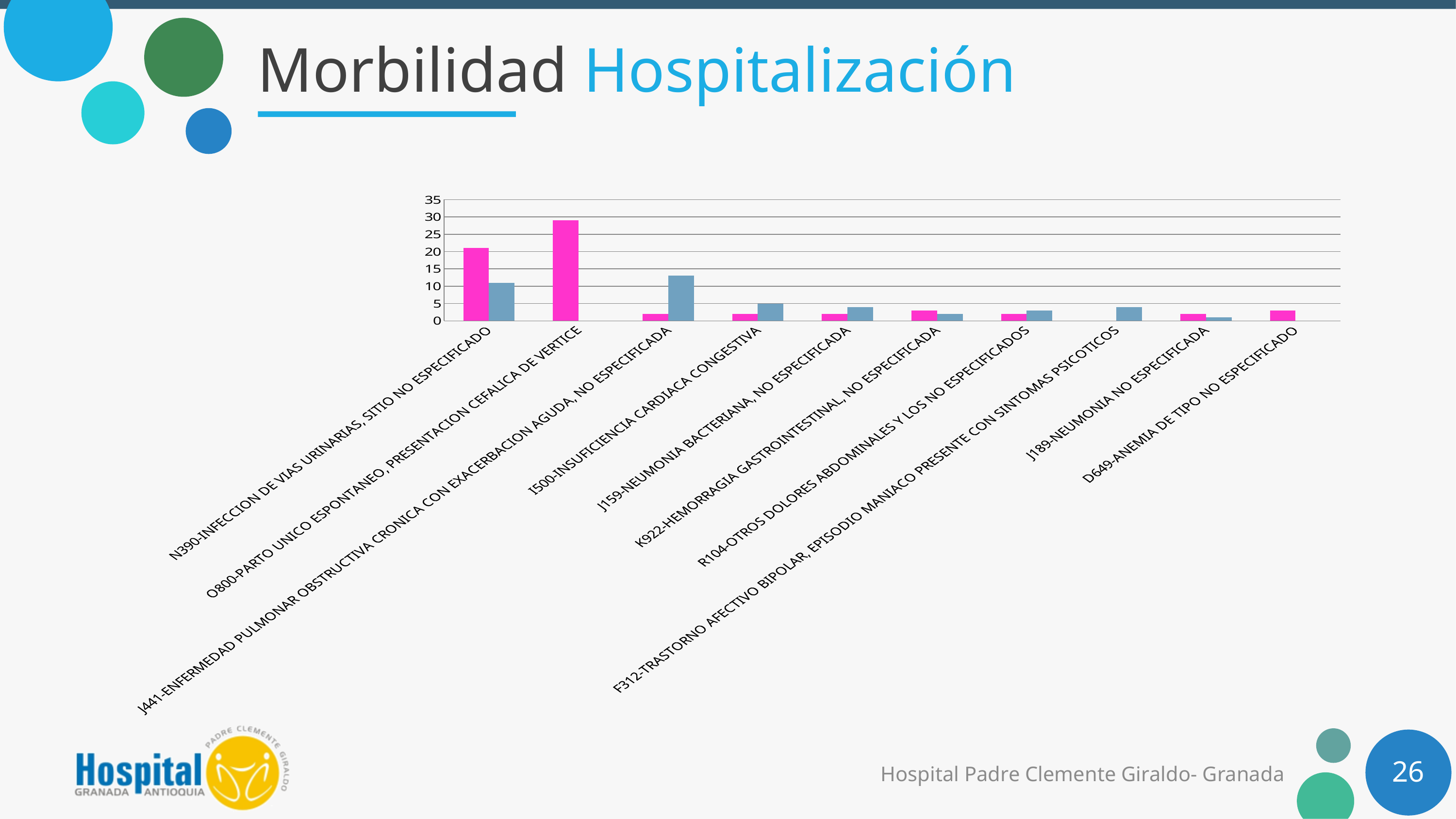
Which category has the tallest blue-gray bar in the chart? J441-ENFERMEDAD PULMONAR OBSTRUCTIVA CRONICA CON EXACERBACION AGUDA, NO ESPECIFICADA Is the blue-gray bar for I500-INSUFICIENCIA CARDIACA CONGESTIVA greater or less than 10? less What is the highest value shown on the chart's vertical axis? 35 Is the blue-gray bar for J441-ENFERMEDAD PULMONAR OBSTRUCTIVA CRONICA CON EXACERBACION AGUDA, NO ESPECIFICADA greater or less than 10? greater For N390-INFECCION DE VIAS URINARIAS, SITIO NO ESPECIFICADO, which bar is taller, the pink one or the blue-gray one? the pink one How many diagnosis categories are shown on the x axis of the chart? 10 For J441-ENFERMEDAD PULMONAR OBSTRUCTIVA CRONICA CON EXACERBACION AGUDA, NO ESPECIFICADA, which bar is taller, the pink one or the blue-gray one? the blue-gray one Is the pink bar for O800-PARTO UNICO ESPONTANEO, PRESENTACION CEFALICA DE VERTICE greater or less than 25? greater What kind of chart is shown on the slide? bar chart Which category has the tallest pink bar in the chart? O800-PARTO UNICO ESPONTANEO, PRESENTACION CEFALICA DE VERTICE